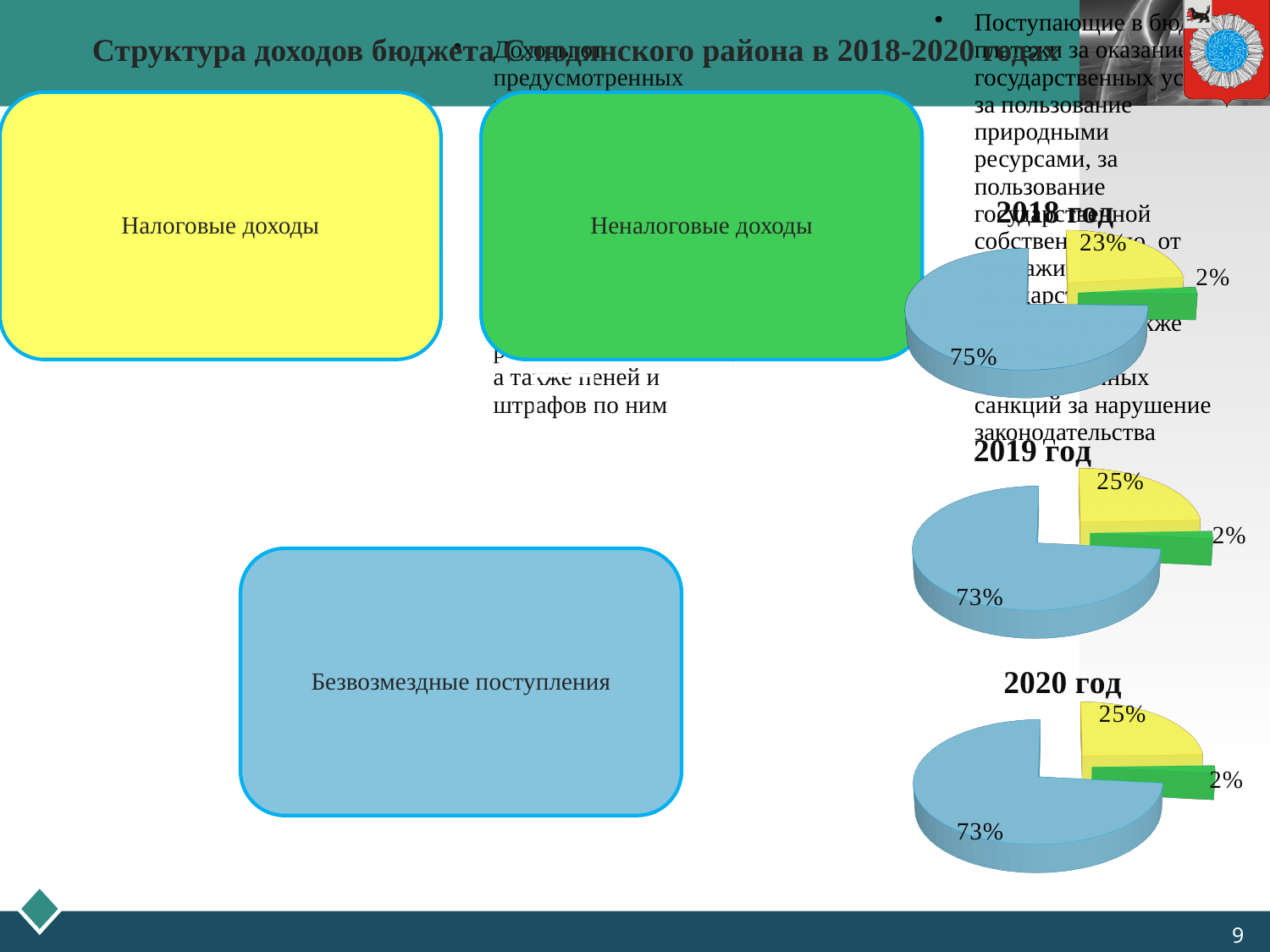
Which chart has the larger yellow slice, 2018 год or 2019 год? 2019 год In the 2018 год pie chart, what is the value of the largest slice? 75% How many slices does the 2020 год pie chart have? 3 How many pie charts are on the slide? 3 In the 2019 год pie chart, what is the value of the blue slice? 73% What type of charts are shown on the right side of the slide? pie chart In the 2020 год pie chart, what share does the yellow slice have? 25% In the 2020 год pie chart, what is the value of the green slice? 2% In the 2019 год pie chart, what is the value of the yellow slice? 25% In the 2018 год pie chart, what is the difference between the yellow slice and the green slice? 21% In the 2018 год pie chart, what is the value of the yellow slice? 23% In the 2018 год pie chart, what is the value of the smallest slice? 2%